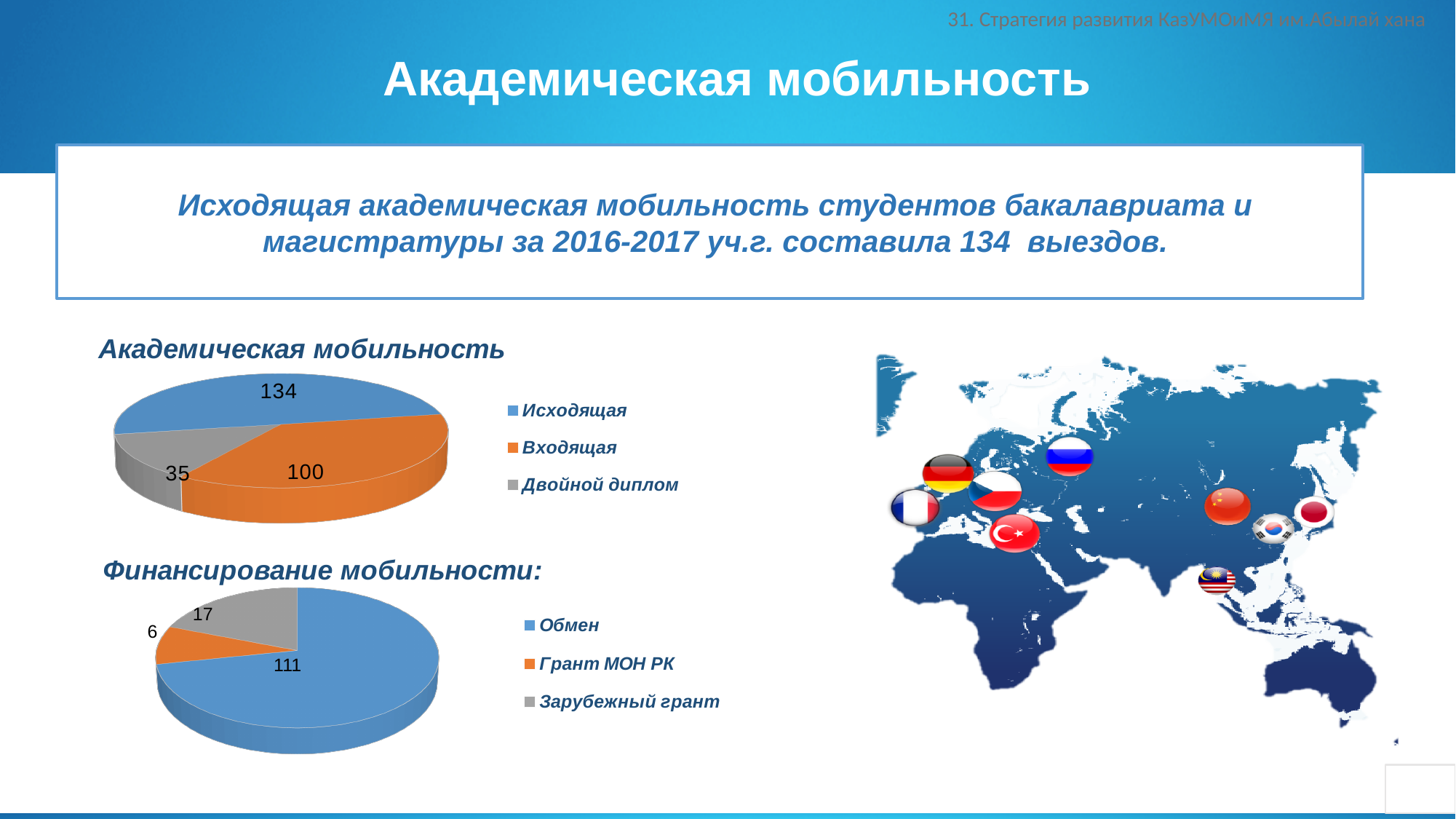
In the 'Финансирование мобильности' pie chart, which is larger: Зарубежный грант or Грант МОН РК? Зарубежный грант In the 'Академическая мобильность' pie chart, how many categories does the legend list? 3 In the 'Финансирование мобильности' pie chart, what is the value for Обмен? 111 What type of chart is used for 'Финансирование мобильности'? Pie chart In the 'Академическая мобильность' pie chart, which category has the largest value? Исходящая In the 'Академическая мобильность' pie chart, what colour is the Входящая slice? Orange In the 'Финансирование мобильности' pie chart, which category has the smallest value? Грант МОН РК In the 'Академическая мобильность' pie chart, what is the value for Двойной диплом? 35 In the 'Академическая мобильность' pie chart, what is the value for Исходящая? 134 In the 'Академическая мобильность' pie chart, what is the difference between Исходящая and Входящая? 34 In the 'Финансирование мобильности' pie chart, what is the total of all three slices? 134 In the 'Финансирование мобильности' pie chart, what is the value for Грант МОН РК? 6